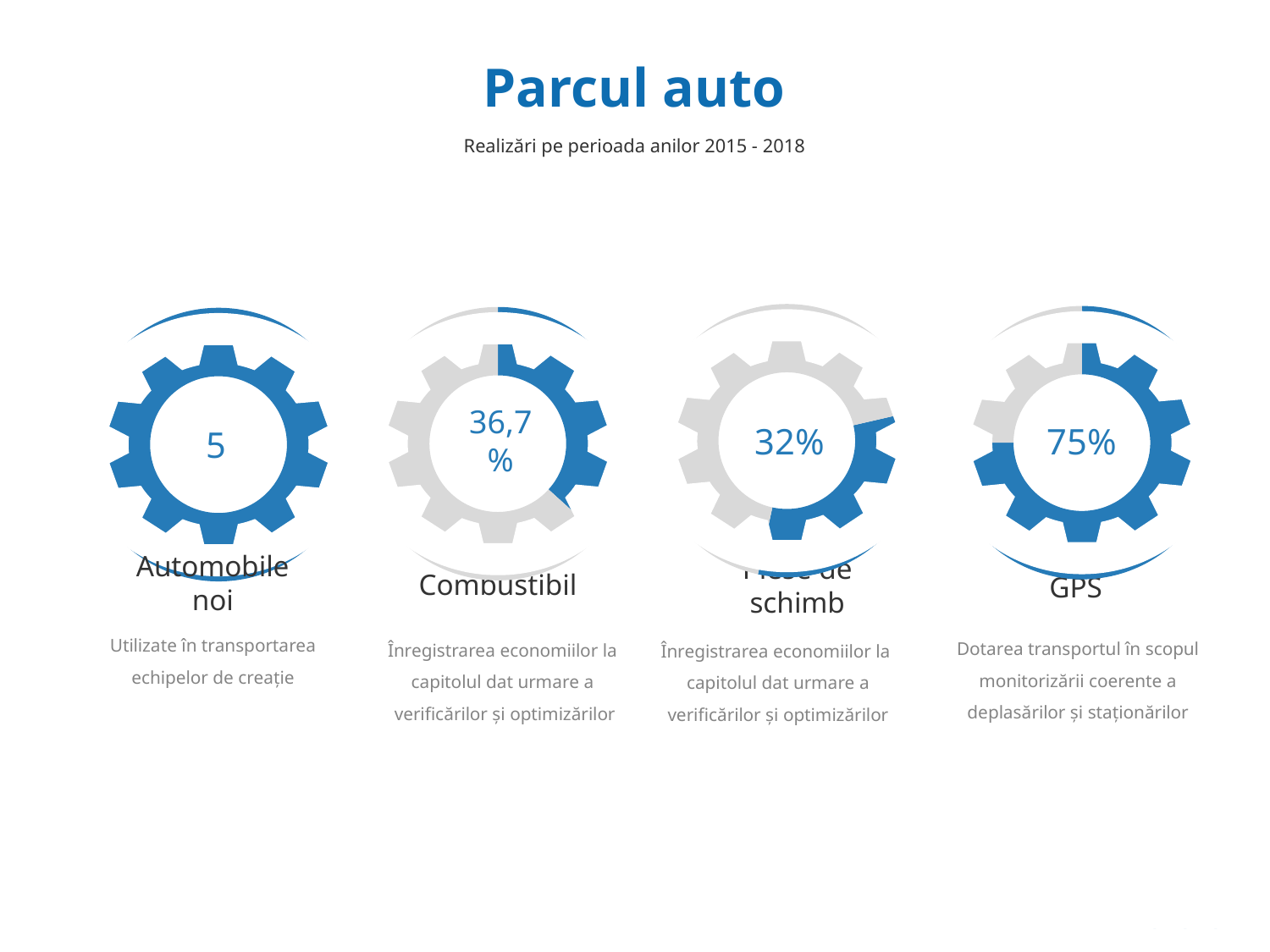
Which of the percentage charts on the slide shows the lowest value? Piese de schimb What kind of chart is used for the GPS value? Doughnut (gauge) chart How many gauge charts are shown on the slide? 4 What value is shown in the centre of the third chart from the left (Piese de schimb)? 32% What is the title of the slide containing the charts? Parcul auto What value is shown in the centre of the GPS chart? 75% What value is shown in the centre of the Combustibil chart? 36,7% Which chart shows a larger value, GPS or Combustibil? GPS What value is shown in the centre of the Automobile noi chart? 5 What is the difference between the GPS value and the Piese de schimb value? 43 percentage points Which of the percentage charts on the slide shows the highest value? GPS What is the difference between the Combustibil value and the Piese de schimb value? 4,7 percentage points